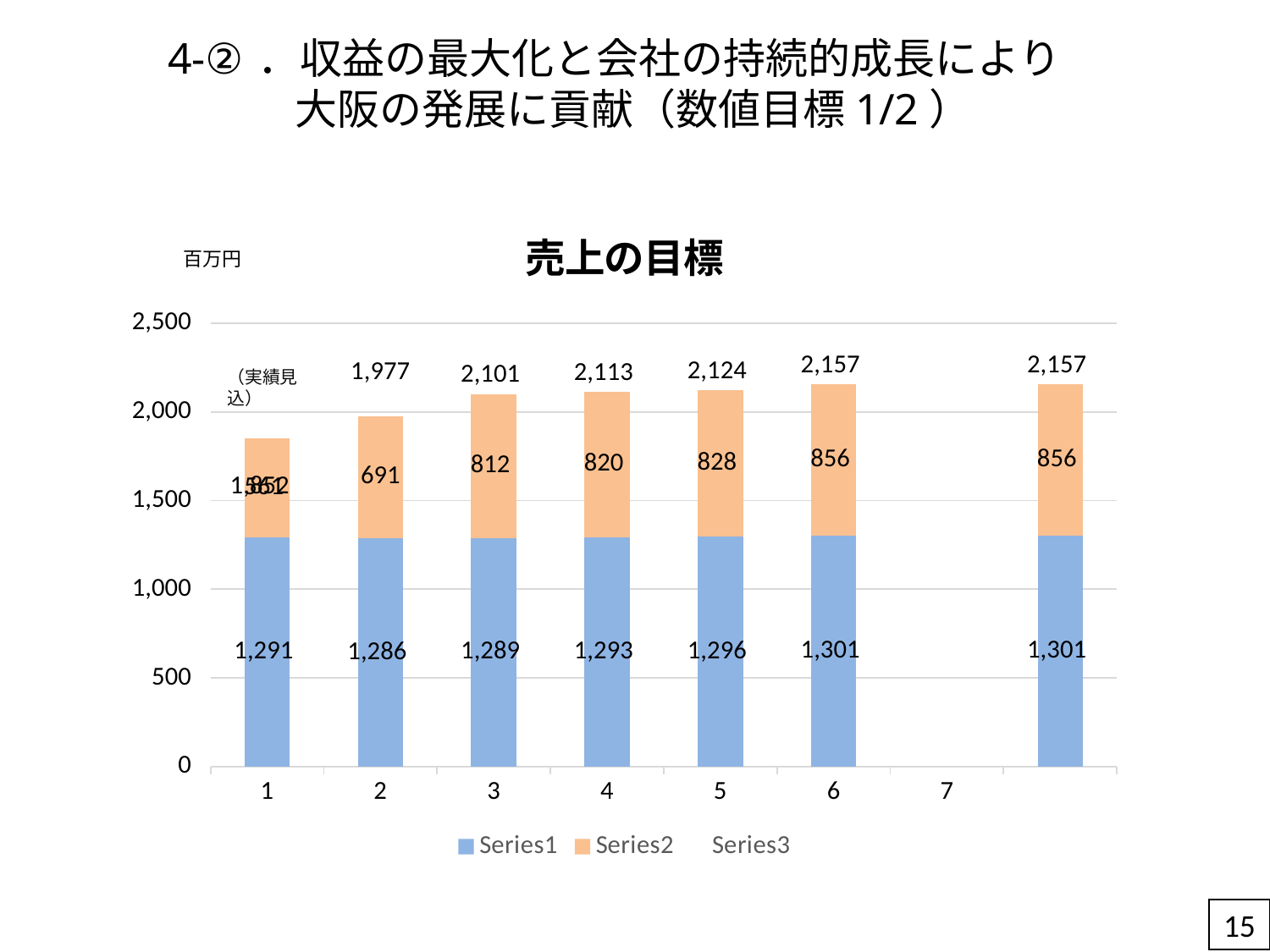
Is the stacked total for category 2 greater or less than 2,000? less What is the Series2 value for category 5? 828 What kind of chart is shown on the slide? bar chart Among categories 2 through 6, which has the lowest stacked total? 2 Which is larger, the Series1 value for category 6 or for category 2? category 6 Do the Series2 values rise or fall from category 2 to category 6? rise What is the total of the stacked bar for category 4? 2,113 What is the Series1 value for category 3? 1,289 How many series does the legend list? 3 What is the difference between the Series2 values for category 4 and category 3? 8 What is the title of the chart? 売上の目標 Among categories 2 through 6, which has the highest Series2 value? 6